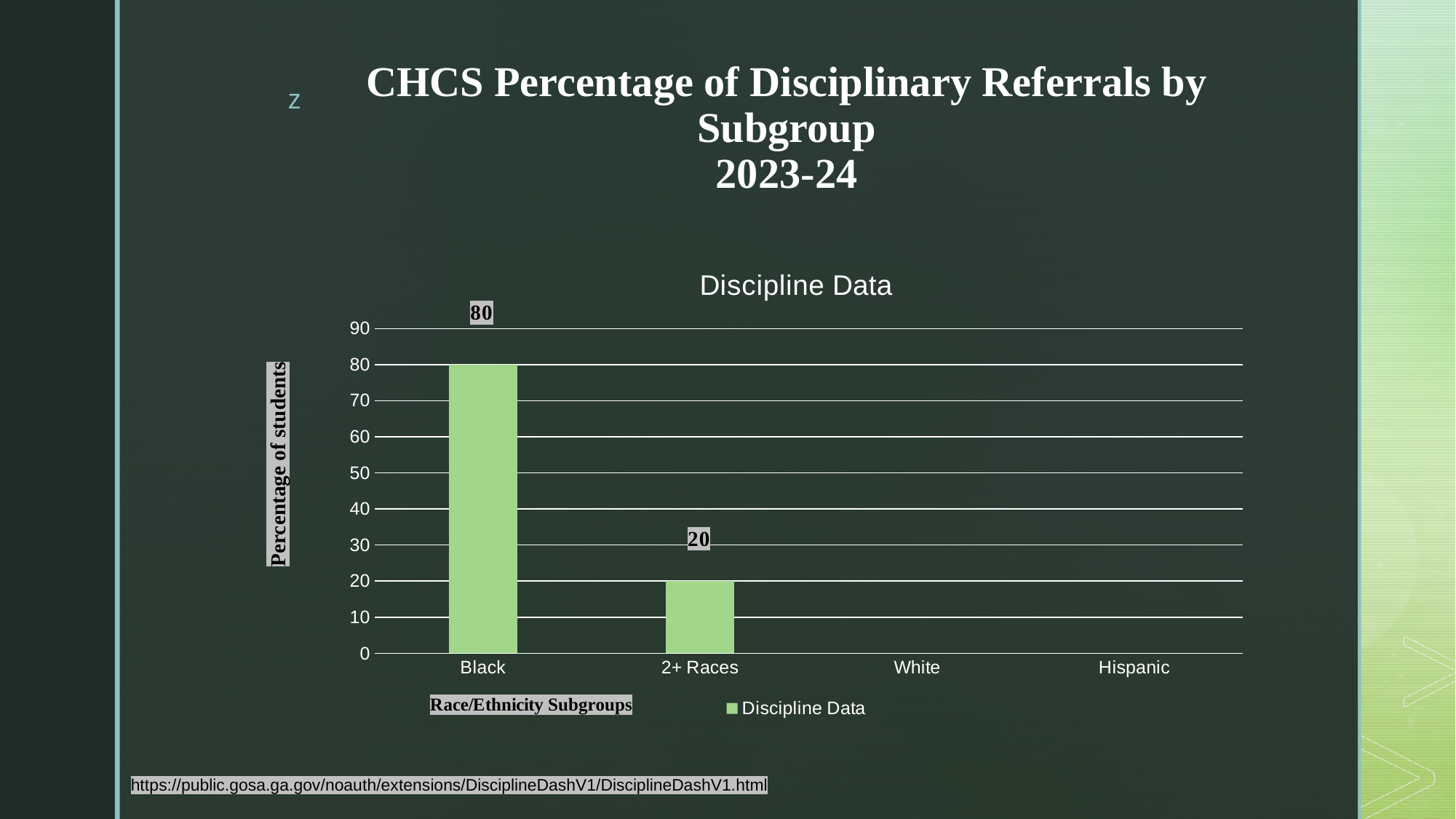
What is the value for 2+ Races in the Discipline Data chart? 20 What is the label of the y axis? Percentage of students What is the title of the chart? Discipline Data How many categories are shown on the x axis of the chart? 4 Which is larger, the value for Black or the value for 2+ Races? Black Is the value for 2+ Races greater or less than 30? less Which category has the highest value in the Discipline Data chart? Black What is the value for Black in the Discipline Data chart? 80 What is the difference between the values for Black and 2+ Races? 60 Is the value for Black greater or less than 50? greater How many series does the legend list? 1 What kind of chart is shown on the slide? bar chart